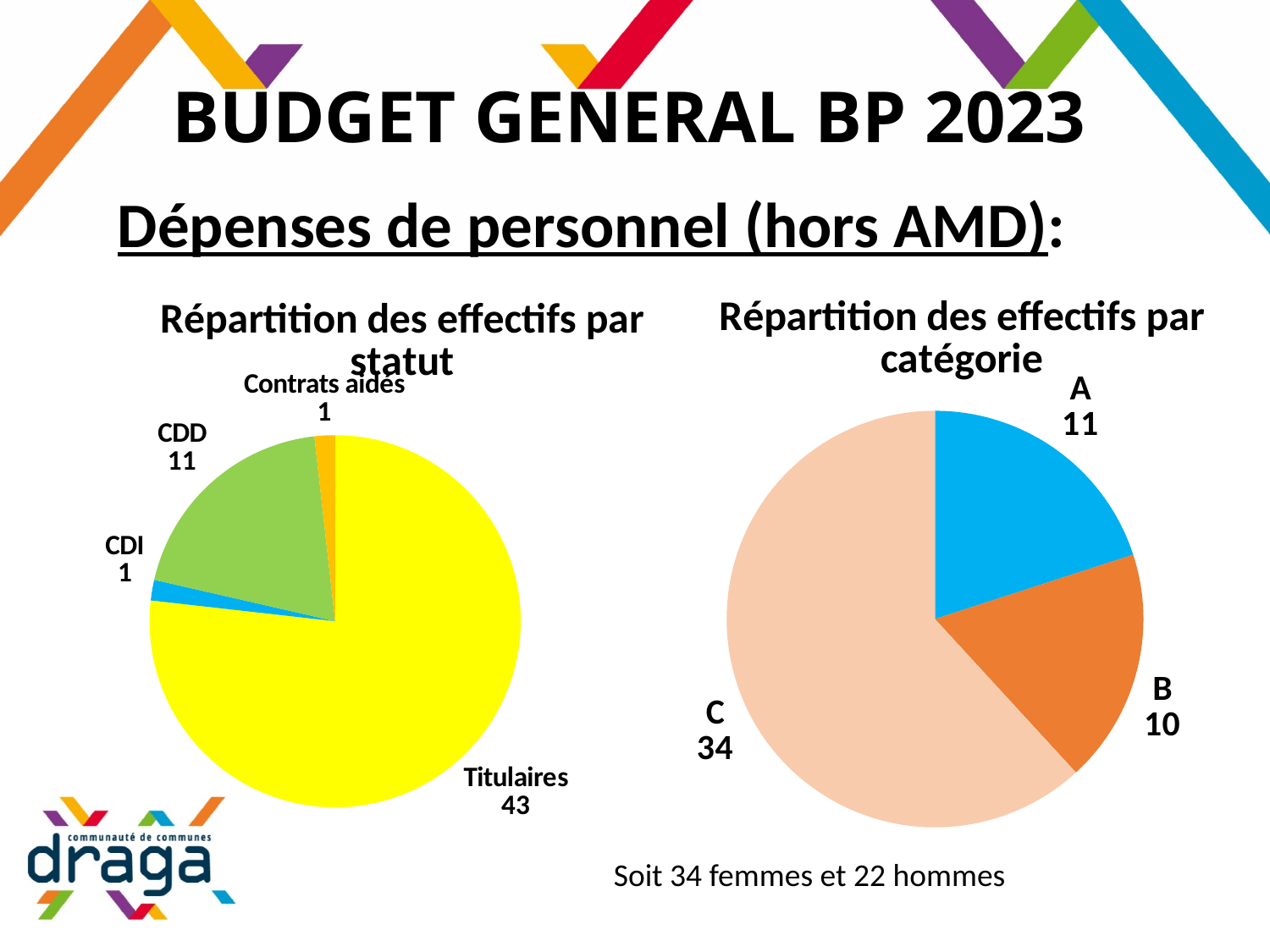
In the 'Répartition des effectifs par statut' chart, what is the difference between Titulaires and CDD? 32 In the 'Répartition des effectifs par catégorie' chart, what is the value for B? 10 In the 'Répartition des effectifs par catégorie' chart, what is the difference between C and A? 23 In the 'Répartition des effectifs par statut' chart, how many categories are shown? 4 In the 'Répartition des effectifs par catégorie' chart, which is larger, A or B? A In the 'Répartition des effectifs par statut' chart, which category has the largest slice? Titulaires In the 'Répartition des effectifs par catégorie' chart, what is the value for C? 34 In the 'Répartition des effectifs par catégorie' chart, which category has the smallest slice? B In the 'Répartition des effectifs par statut' chart, what is the value for CDD? 11 What colour is the Titulaires slice in the 'Répartition des effectifs par statut' chart? yellow What type of chart is 'Répartition des effectifs par statut'? pie chart In the 'Répartition des effectifs par statut' chart, what is the value for Titulaires? 43